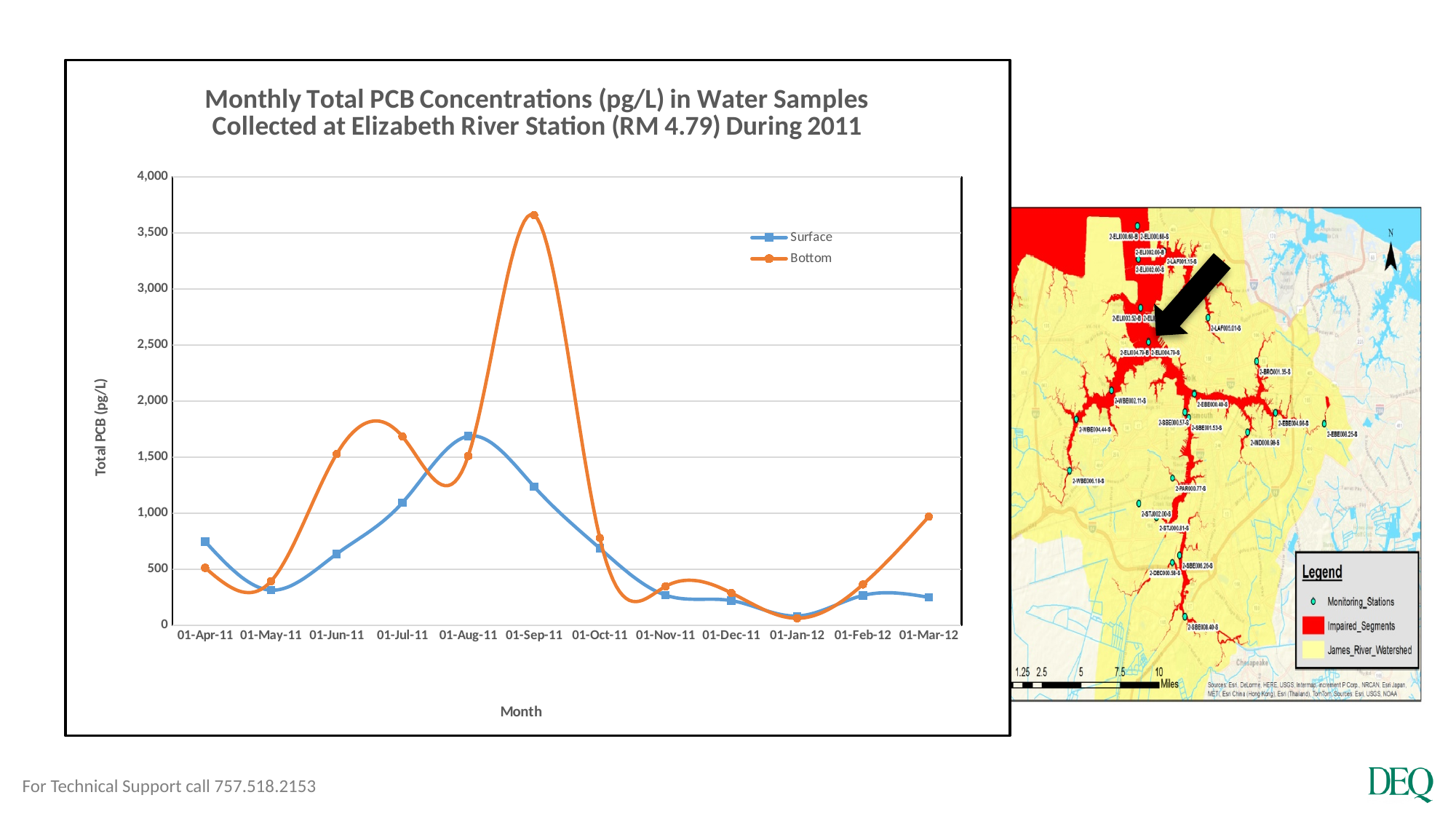
At 01-Sep-11, which series has the larger value, Surface or Bottom? Bottom Is the Bottom value for 01-Sep-11 greater or less than 3,500? greater In which month does the Bottom series reach its highest value? 01-Sep-11 In which month does the Surface series reach its highest value? 01-Aug-11 Is the Surface value for 01-Aug-11 greater or less than 1,500? greater What is the label on the chart's vertical axis? Total PCB (pg/L) How many series does the chart's legend list? 2 In which month does the Bottom series reach its lowest value? 01-Jan-12 Does the Bottom series rise or fall from 01-Sep-11 to 01-Jan-12? fall At 01-Apr-11, which series has the larger value, Surface or Bottom? Surface How many months are plotted along the x axis of the chart? 12 What kind of chart is shown on the slide? line chart